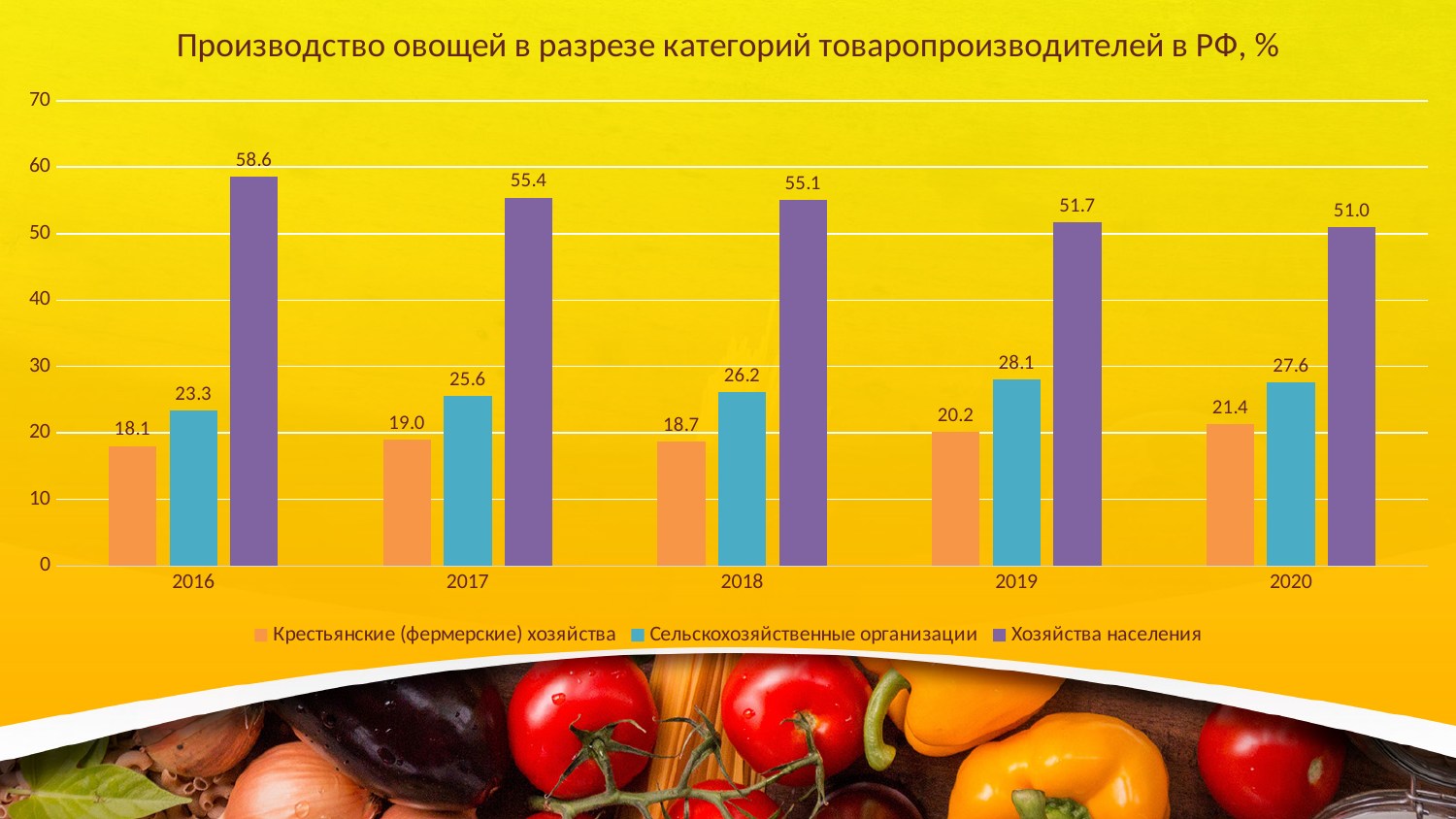
What is the title of the chart? Производство овощей в разрезе категорий товаропроизводителей в РФ, % What kind of chart is shown on the slide? Bar chart What is the difference between the Хозяйства населения values in 2016 and 2020? 7.6 What is the value for Сельскохозяйственные организации in 2019? 28.1 In which year is the value for Крестьянские (фермерские) хозяйства the lowest? 2016 What is the value for Крестьянские (фермерские) хозяйства in 2020? 21.4 How many years are shown on the x axis? 5 What is the value for Хозяйства населения in 2016? 58.6 In which year is the value for Хозяйства населения the highest? 2016 Which is larger: Сельскохозяйственные организации in 2018 or Крестьянские (фермерские) хозяйства in 2018? Сельскохозяйственные организации Do the values for Хозяйства населения rise or fall from 2016 to 2020? Fall How many series does the legend list? 3